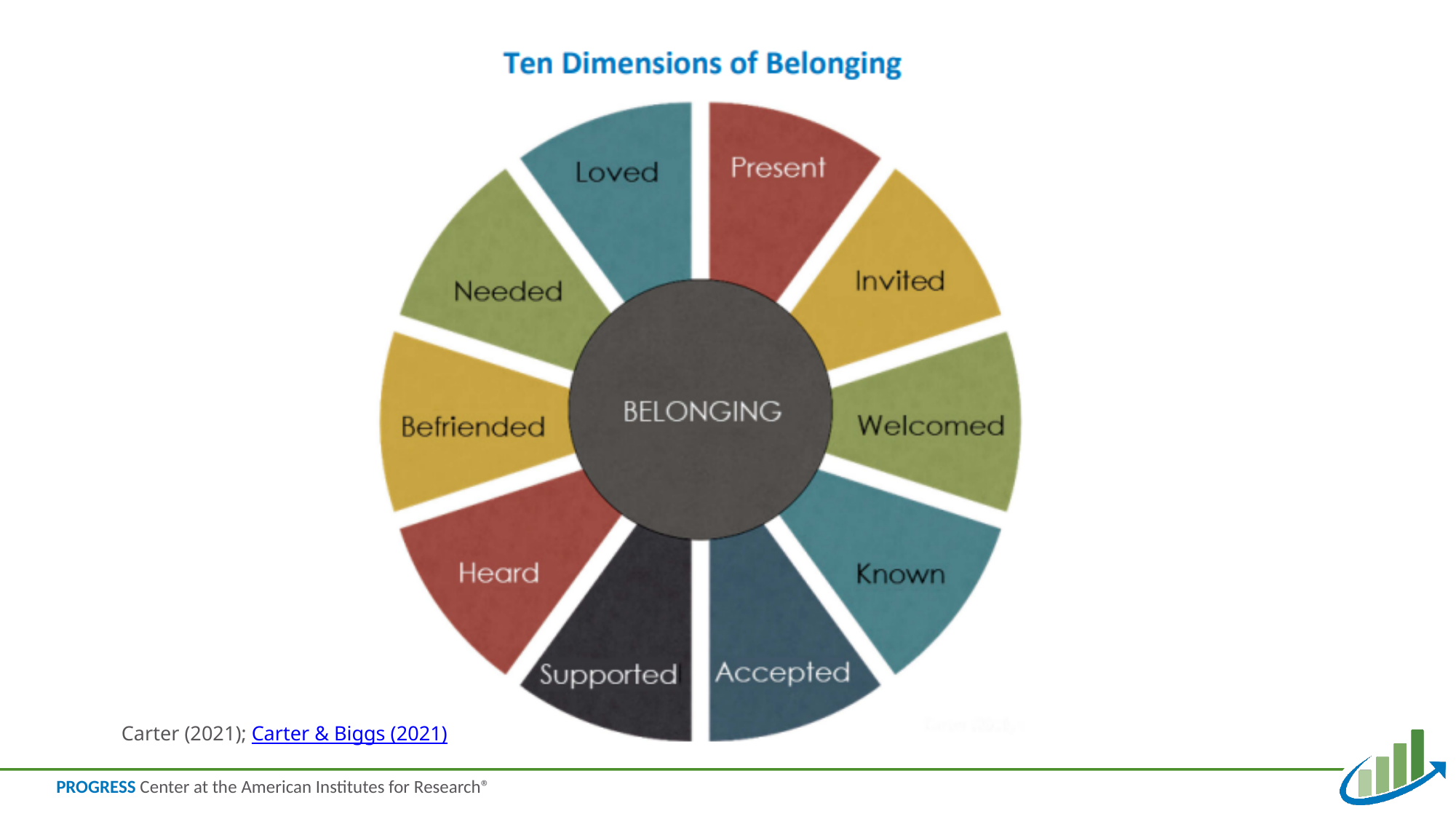
What is the title of the diagram on the slide? Ten Dimensions of Belonging Which segment sits between the Needed and Heard segments in the wheel diagram? Befriended How many segments does the wheel diagram contain? 10 What word appears in the centre circle of the wheel diagram? BELONGING Which segment sits between the Present and Welcomed segments in the wheel diagram? Invited Which segment sits between the Heard and Accepted segments in the wheel diagram? Supported Which segment sits between the Welcomed and Accepted segments in the wheel diagram? Known Which segment is directly to the left of the Present segment at the top of the wheel diagram? Loved